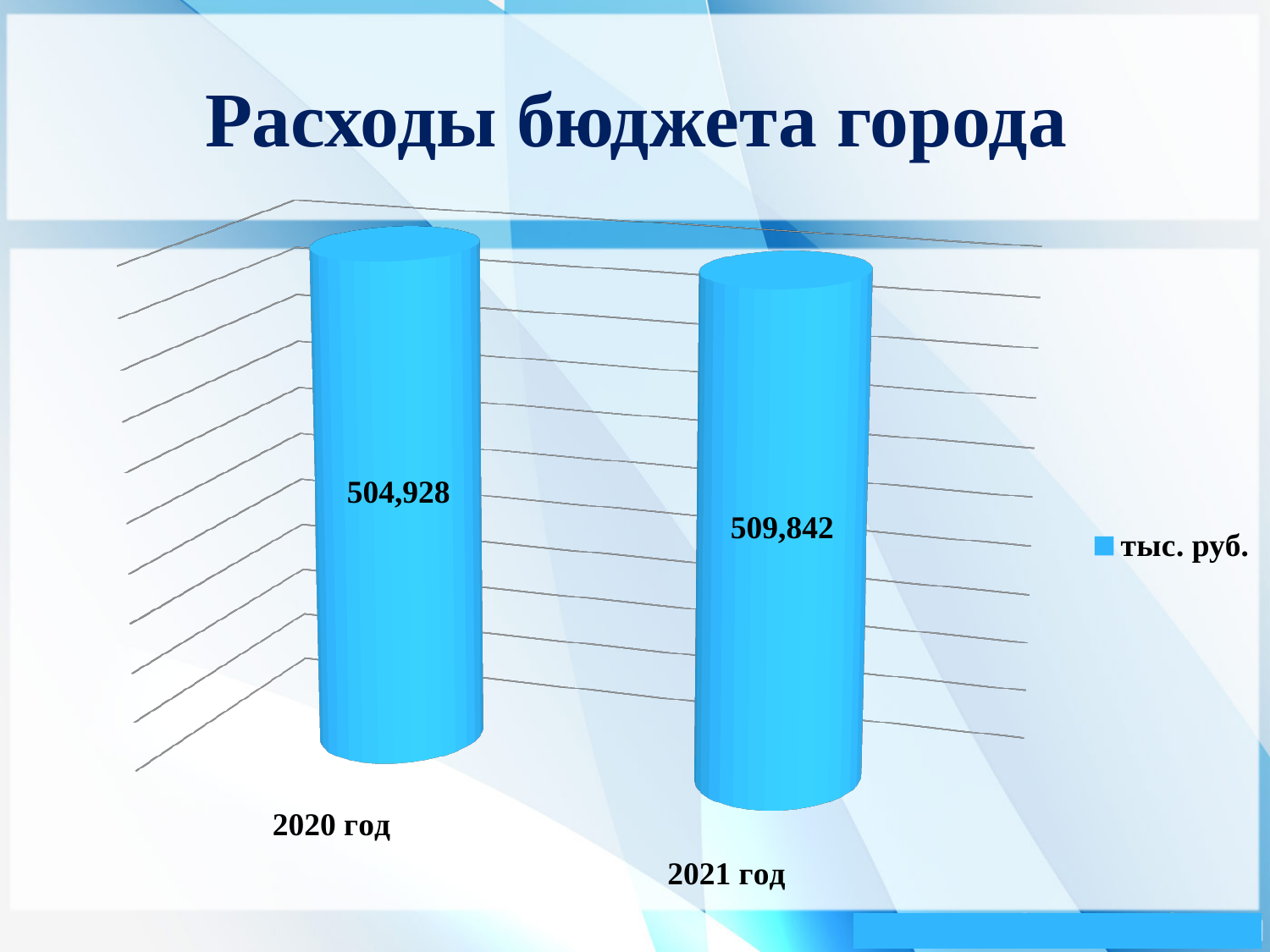
Is the value for 2021 год larger or smaller than the value for 2020 год? larger What kind of chart is shown on the slide? bar chart How many categories are shown on the chart? 2 Which year has the higher value? 2021 год Do the values rise or fall from 2020 год to 2021 год? rise How many series does the legend list? 1 What is the value for 2021 год? 509,842 What is the legend entry of the chart? тыс. руб. What is the value for 2020 год? 504,928 What is the title of the chart? Расходы бюджета города What is the difference between the values for 2021 год and 2020 год? 4,914 Which year has the lower value? 2020 год